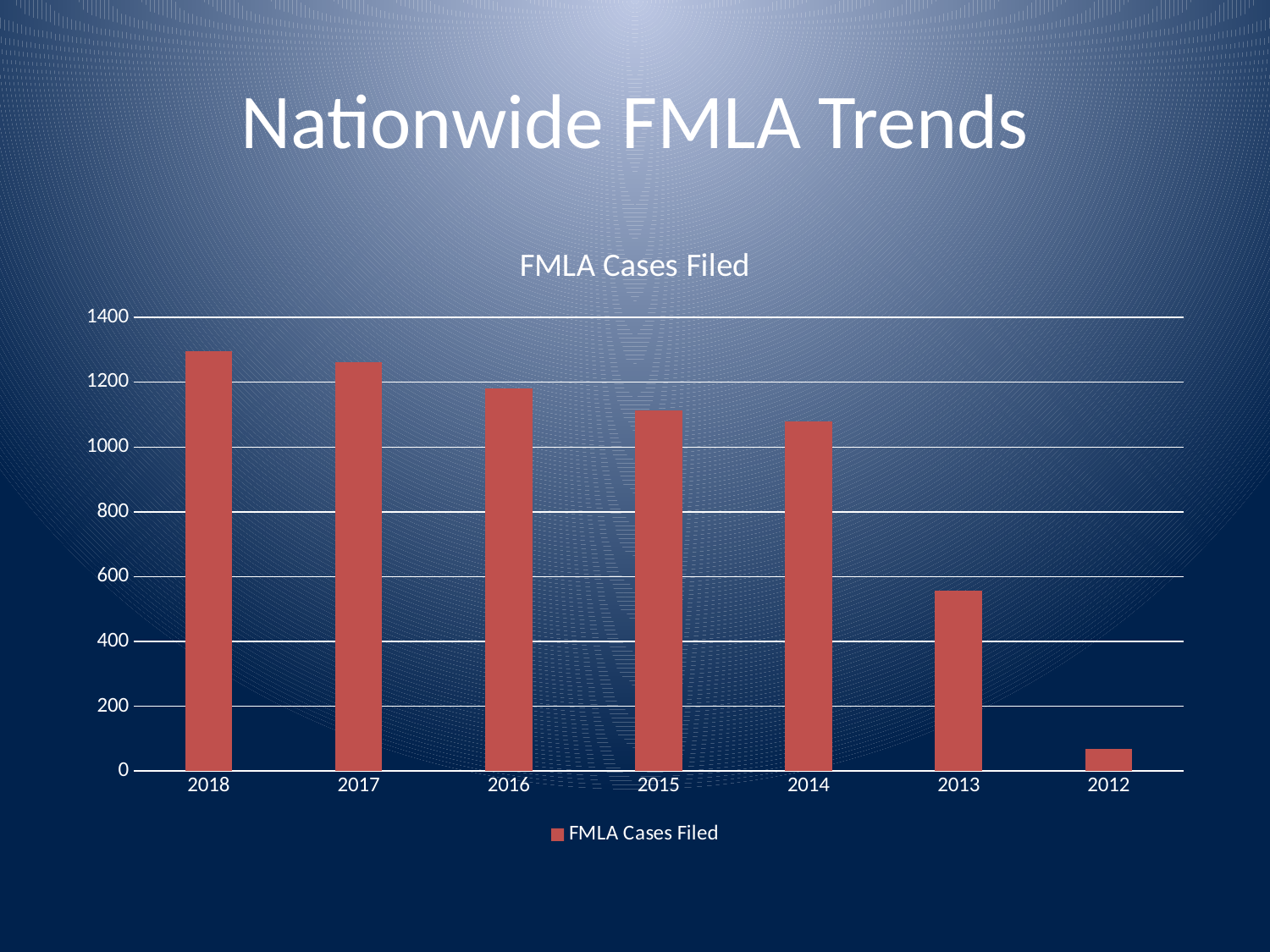
Is the value for 2012 greater or less than 200? less Do the values rise or fall moving from left to right along the x axis? fall How many series does the chart's legend list? 1 What is the title of the chart? FMLA Cases Filed What kind of chart is shown on the slide? bar chart Which year has the highest number of FMLA cases filed? 2018 Which year has the lowest number of FMLA cases filed? 2012 Which is larger, the value for 2016 or the value for 2015? 2016 Is the value for 2013 greater or less than 600? less Which is larger, the value for 2014 or the value for 2013? 2014 How many years are shown on the x axis of the chart? 7 Is the value for 2016 greater or less than 1000? greater